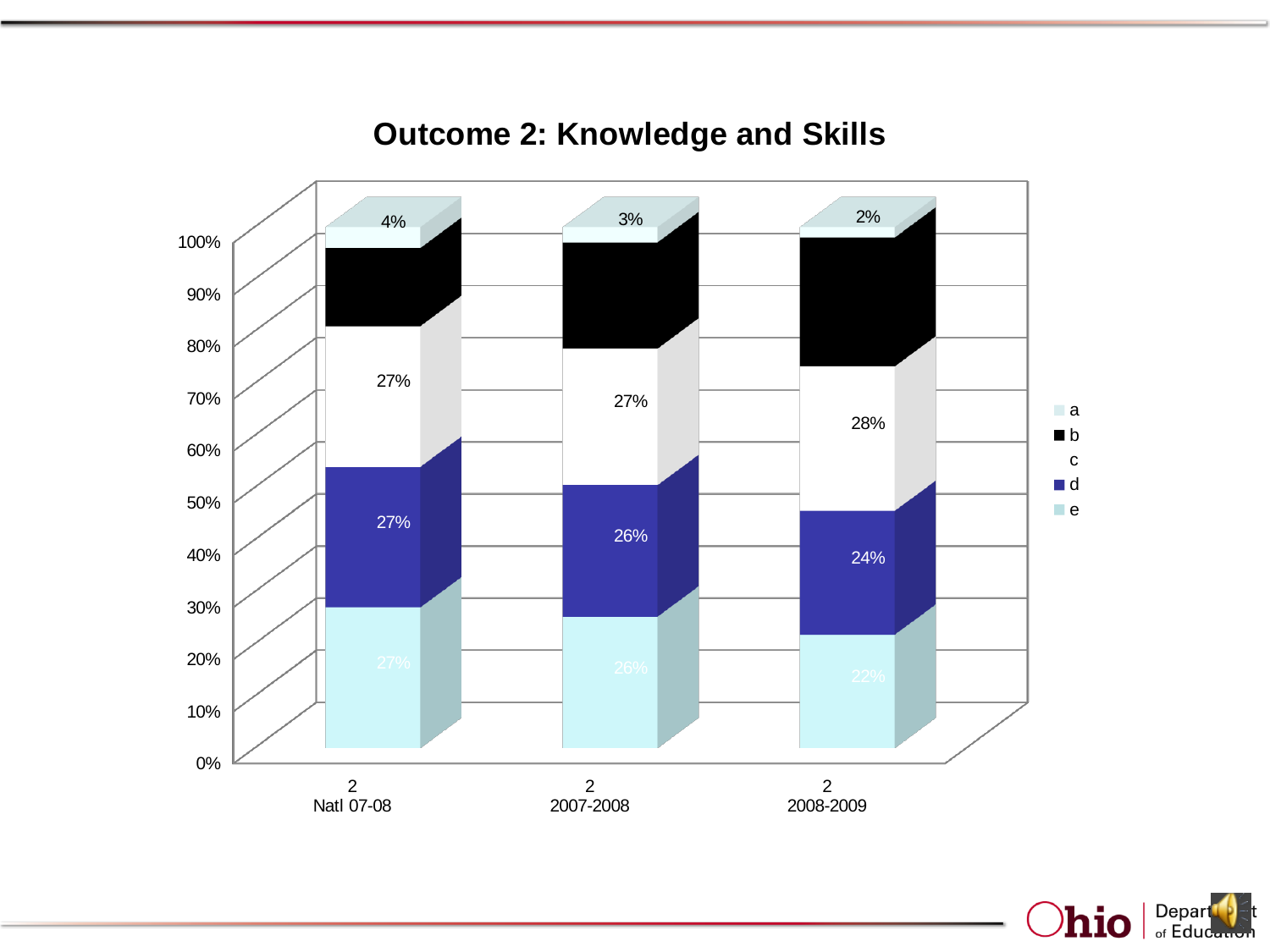
What is the title of the chart? Outcome 2: Knowledge and Skills How many series does the legend list? 5 What kind of chart is shown on the slide? Stacked bar chart What is the value of series e for 2008-2009? 22% What is the value of series c for 2007-2008? 27% What is the difference between the series d value for Natl 07-08 and for 2008-2009? 3 percentage points Which category has the highest value for series a? Natl 07-08 Do the values of series a rise or fall from left to right along the x axis? Fall Which category has the lowest value for series d? 2008-2009 How many bars (categories) are plotted on the x axis? 3 What is the value of series d for Natl 07-08? 27% What is the value of series a for 2008-2009? 2%